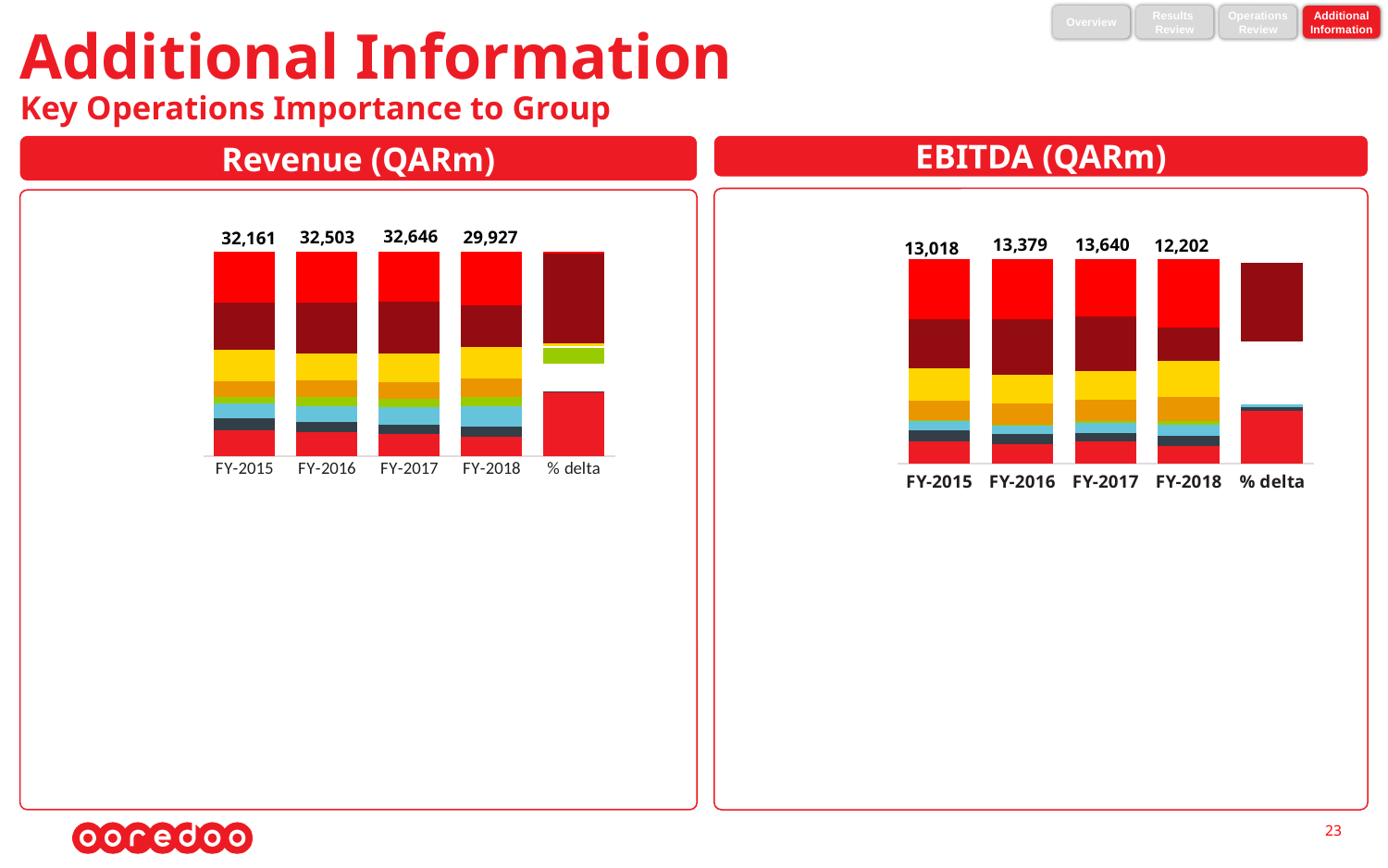
In the EBITDA (QARm) chart, which fiscal year has the lowest labelled total? FY-2018 In the Revenue (QARm) chart, what is the difference between the FY-2017 total and the FY-2018 total? 2,719 In the Revenue (QARm) chart, what is the total revenue labelled for FY-2018? 29,927 In the EBITDA (QARm) chart, which is larger, the FY-2016 total or the FY-2015 total? FY-2016 In the Revenue (QARm) chart, which fiscal year has the highest labelled total? FY-2017 What type of chart is the EBITDA (QARm) chart? Stacked bar chart In the Revenue (QARm) chart, how do the labelled totals change from FY-2015 through FY-2018? Rise through FY-2017, then fall in FY-2018 In the Revenue (QARm) chart, what is the total revenue labelled for FY-2017? 32,646 In the EBITDA (QARm) chart, what is the total EBITDA labelled for FY-2015? 13,018 In the EBITDA (QARm) chart, what is the difference between the FY-2017 total and the FY-2018 total? 1,438 In the EBITDA (QARm) chart, what is the total EBITDA labelled for FY-2016? 13,379 In the Revenue (QARm) chart, how many fiscal years (FY-labelled bars) are shown? 4